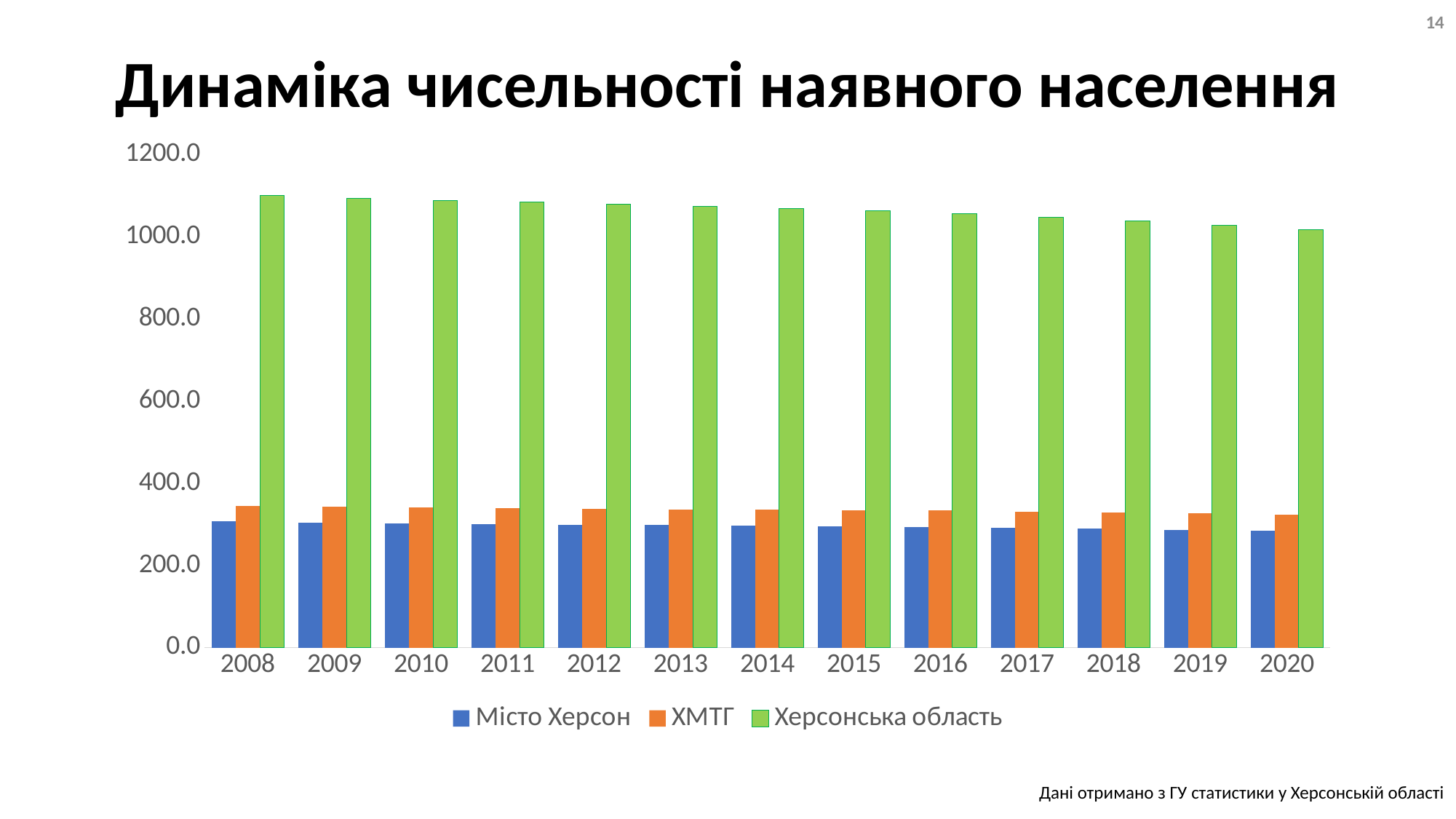
Is the value for ХМТГ in 2020 greater or less than 200? greater Which series has the lowest value in 2020? Місто Херсон How many years are shown on the x axis? 13 What is the title of the chart? Динаміка чисельності наявного населення What kind of chart is shown on the slide? bar chart Which is larger for Херсонська область, 2008 or 2020? 2008 Which is larger in 2008, Місто Херсон or ХМТГ? ХМТГ Which series has the highest value in 2008? Херсонська область Do the values for Херсонська область rise or fall from 2008 to 2020? fall Is the value for Херсонська область in 2008 greater or less than 1000? greater Is the value for Місто Херсон in 2008 greater or less than 400? less How many series does the legend list? 3